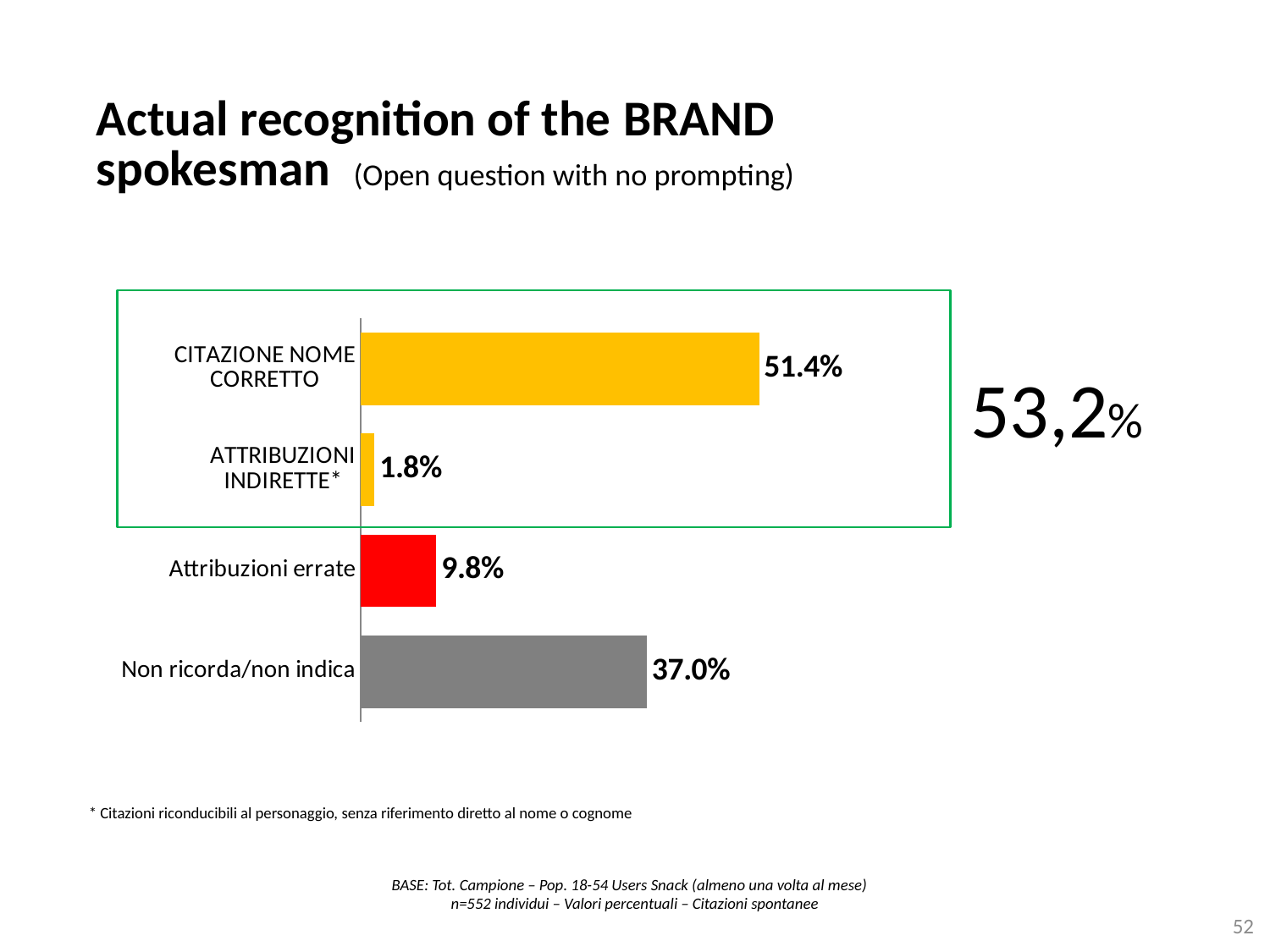
How many categories are shown in the chart? 4 What colour is the bar for Attribuzioni errate? Red Which is larger, the value for Attribuzioni errate or the value for Non ricorda/non indica? Non ricorda/non indica What is the difference between the values for CITAZIONE NOME CORRETTO and Non ricorda/non indica? 14.4% What is the value for Non ricorda/non indica? 37.0% What is the value for Attribuzioni errate? 9.8% What is the value for ATTRIBUZIONI INDIRETTE*? 1.8% What is the value for CITAZIONE NOME CORRETTO? 51.4% What kind of chart is shown on the slide? Bar chart Which category has the lowest value? ATTRIBUZIONI INDIRETTE* Which category has the highest value? CITAZIONE NOME CORRETTO What is the combined total of CITAZIONE NOME CORRETTO and ATTRIBUZIONI INDIRETTE* shown next to the green box? 53,2%